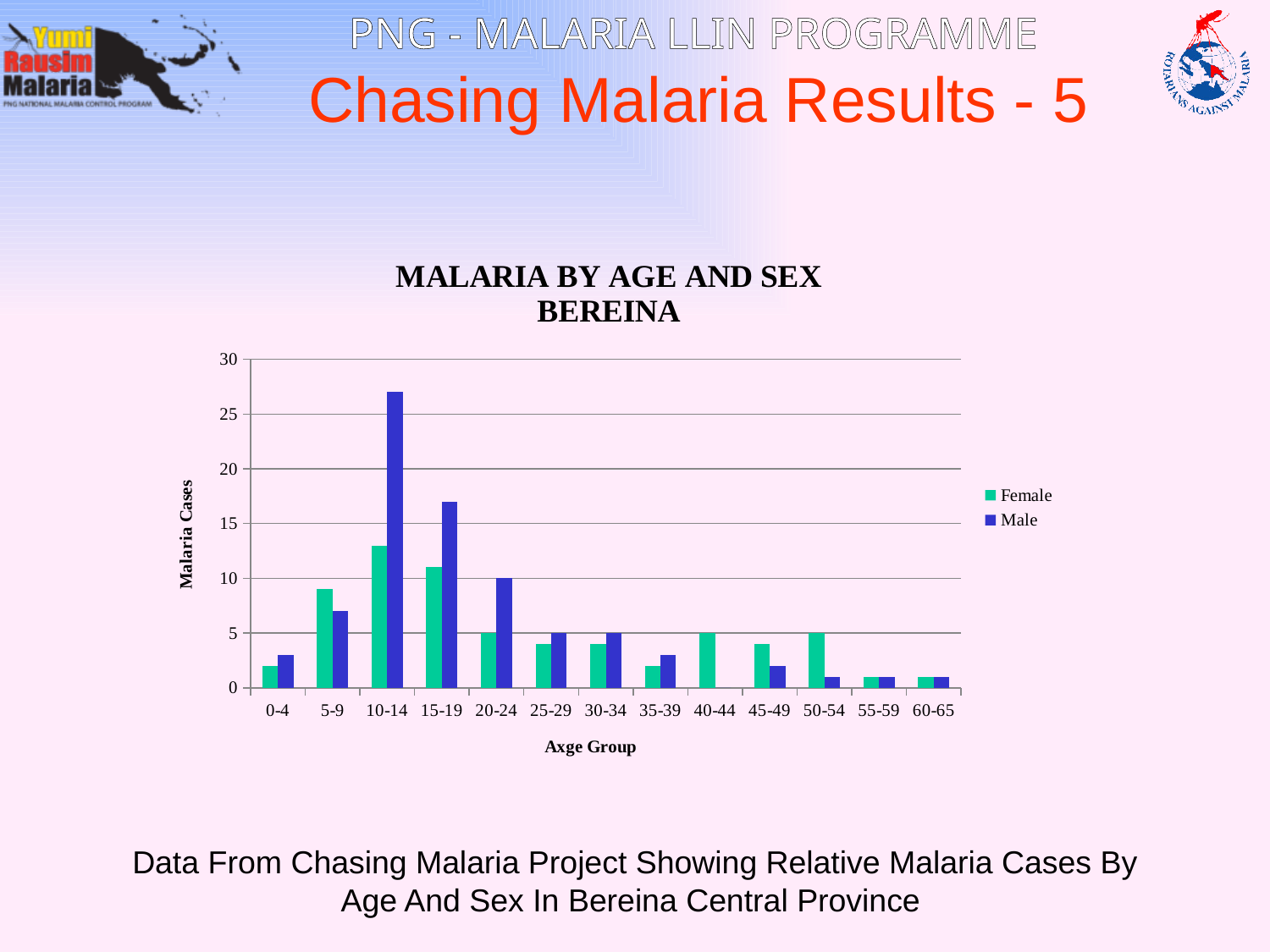
Is the value for Male in the 15-19 age group greater or less than 15? greater Is the value for Female in the 10-14 age group greater or less than 15? less Which is larger in the 45-49 age group, the Female value or the Male value? Female How many age groups are shown on the x axis of the chart? 13 Which age group has the highest number of female malaria cases? 10-14 Which age group has the highest number of male malaria cases? 10-14 Which is larger in the 10-14 age group, the Female value or the Male value? Male Is the value for Female in the 5-9 age group greater or less than 10? less What is the title of the chart? MALARIA BY AGE AND SEX BEREINA What type of chart is shown on the slide? bar chart How many series does the chart legend list? 2